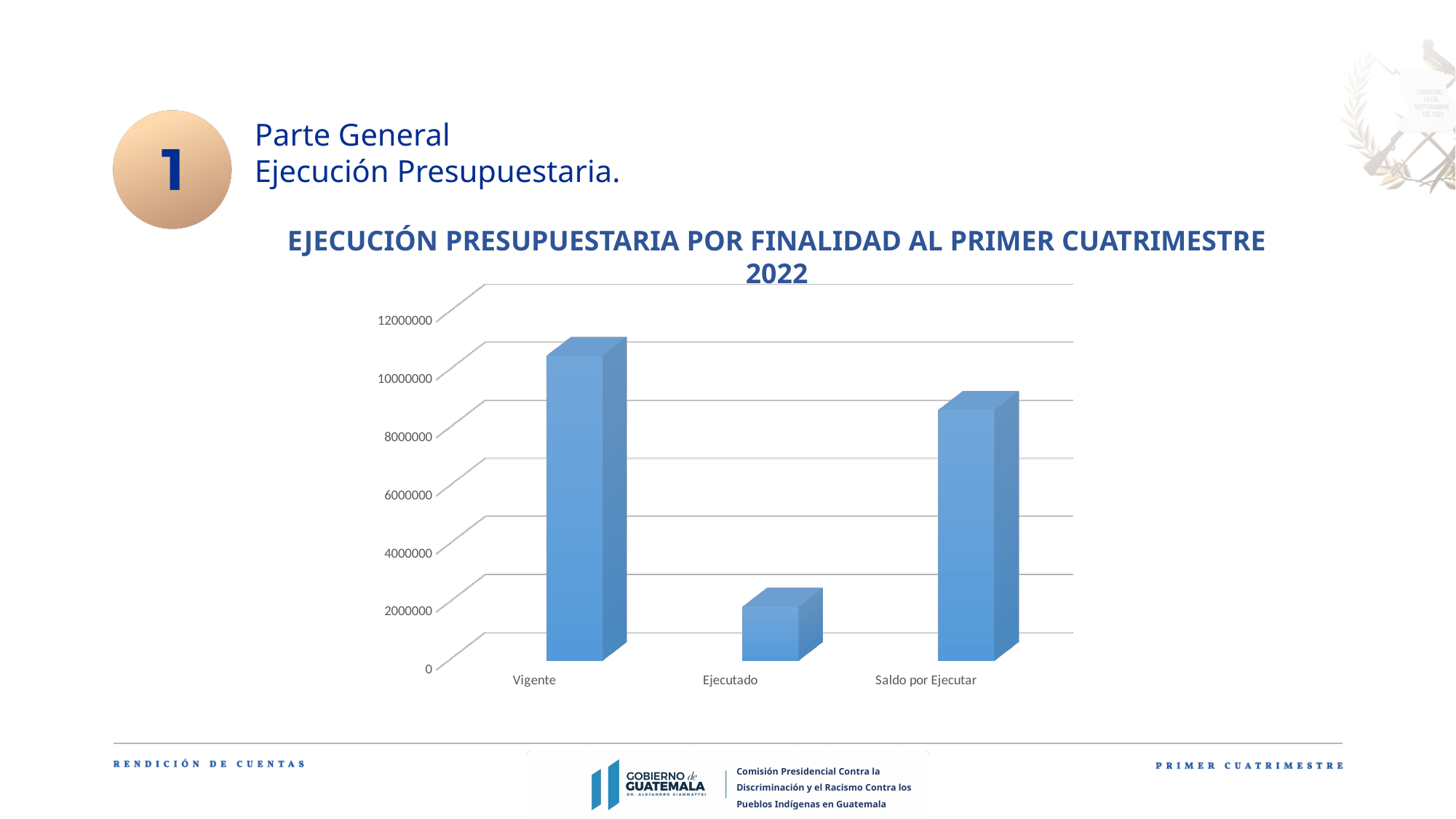
Is the value for Ejecutado greater or less than 4000000? less Does the value rise or fall from Vigente to Ejecutado? fall Which category has the highest value in the chart? Vigente Is the value for Saldo por Ejecutar greater or less than 10000000? less What is the title of the chart? EJECUCIÓN PRESUPUESTARIA POR FINALIDAD AL PRIMER CUATRIMESTRE 2022 Which is larger, the value for Vigente or the value for Saldo por Ejecutar? Vigente Which is larger, the value for Ejecutado or the value for Saldo por Ejecutar? Saldo por Ejecutar What kind of chart is shown on the slide? bar chart How many categories are shown on the x axis of the chart? 3 Is the value for Saldo por Ejecutar greater or less than 8000000? greater Which category has the lowest value in the chart? Ejecutado